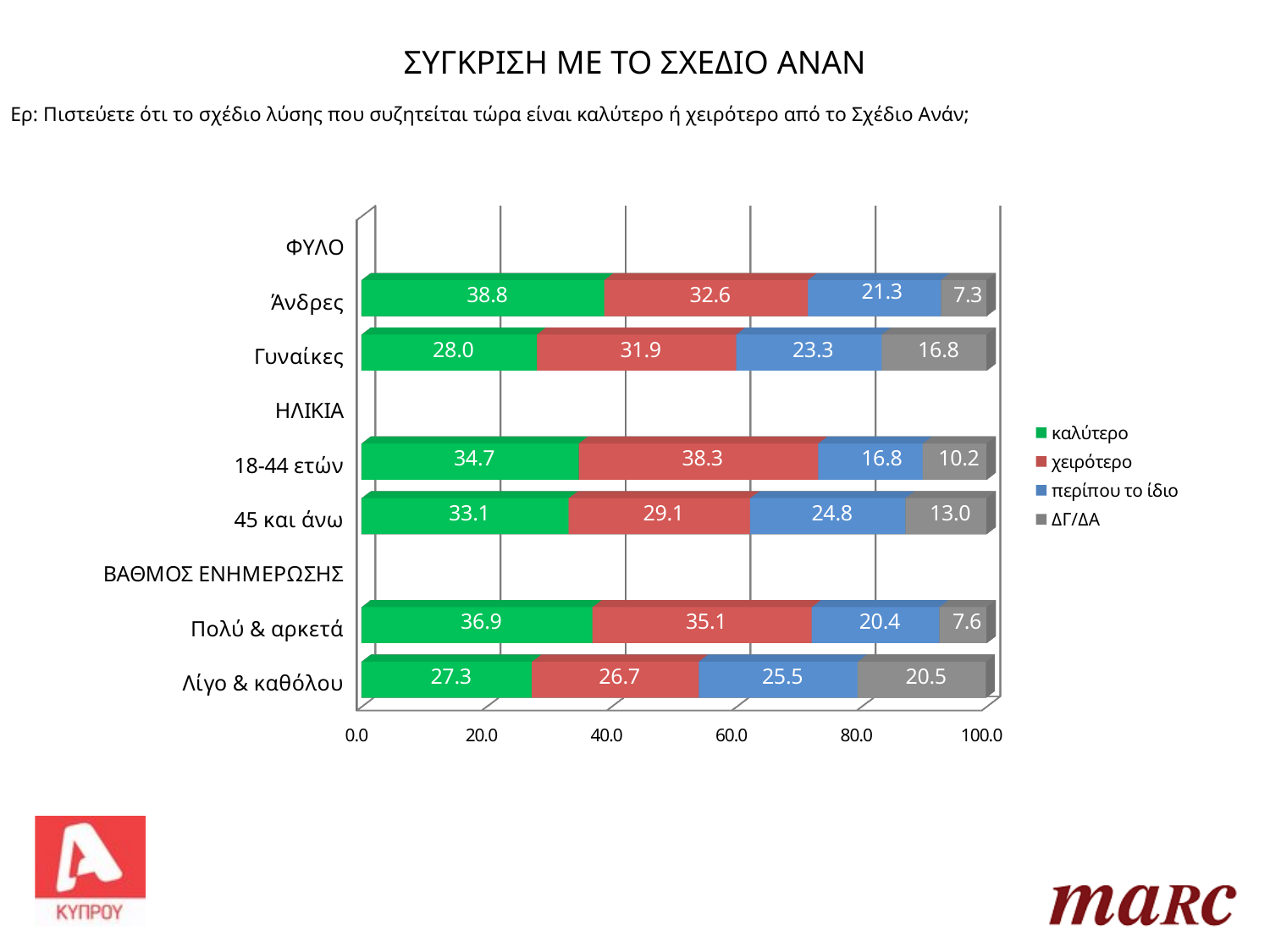
What is the value for ΔΓ/ΔΑ among Γυναίκες? 16.8 What is the total of the stacked bar for Λίγο & καθόλου? 100.0 How many series does the legend list? 4 What is the value for περίπου το ίδιο in the 45 και άνω group? 24.8 What is the difference between the καλύτερο values for Άνδρες and Γυναίκες? 10.8 Which series is shown in green in the legend? καλύτερο What kind of chart is shown on the slide? Stacked bar chart Which is larger: the χειρότερο value for Πολύ & αρκετά or for Λίγο & καθόλου? Πολύ & αρκετά Which group has the lowest value for ΔΓ/ΔΑ? Άνδρες What is the value for χειρότερο in the 18-44 ετών group? 38.3 Which group has the highest value for καλύτερο? Άνδρες What is the value for καλύτερο among Άνδρες? 38.8